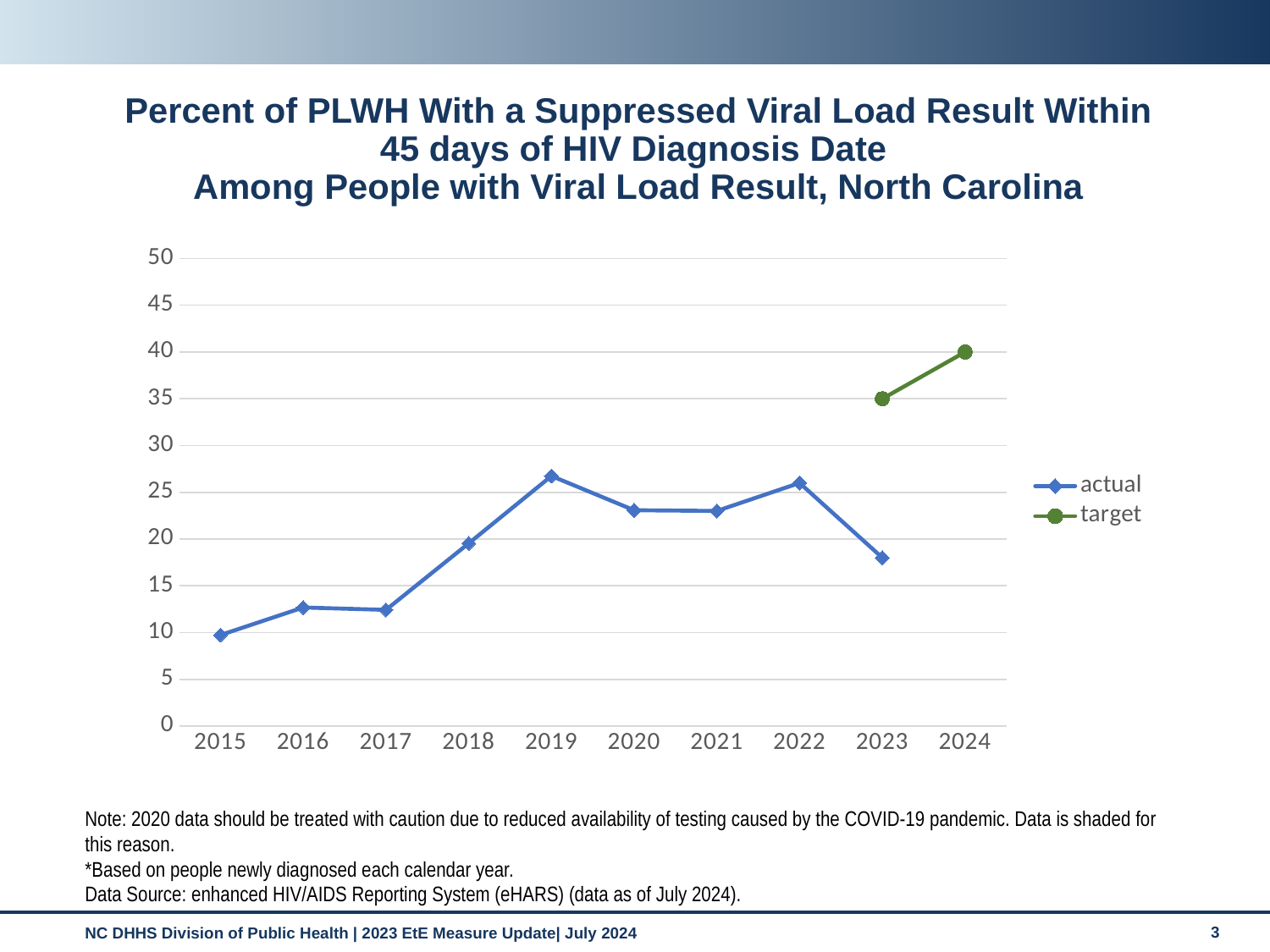
Is the actual value for 2023 greater or less than 20? less Is the actual value for 2019 greater or less than 25? greater What is the difference between the target for 2024 and the target for 2023? 5 Which is larger, the actual value for 2019 or the actual value for 2023? 2019 What kind of chart is shown on the slide? line chart Which year has the lowest actual value? 2015 What colour is the target series line? green What is the target value for 2024? 40 Do the actual values rise or fall from 2015 to 2019? rise How many series does the legend list? 2 How many years are shown on the x axis? 10 What is the target value for 2023? 35